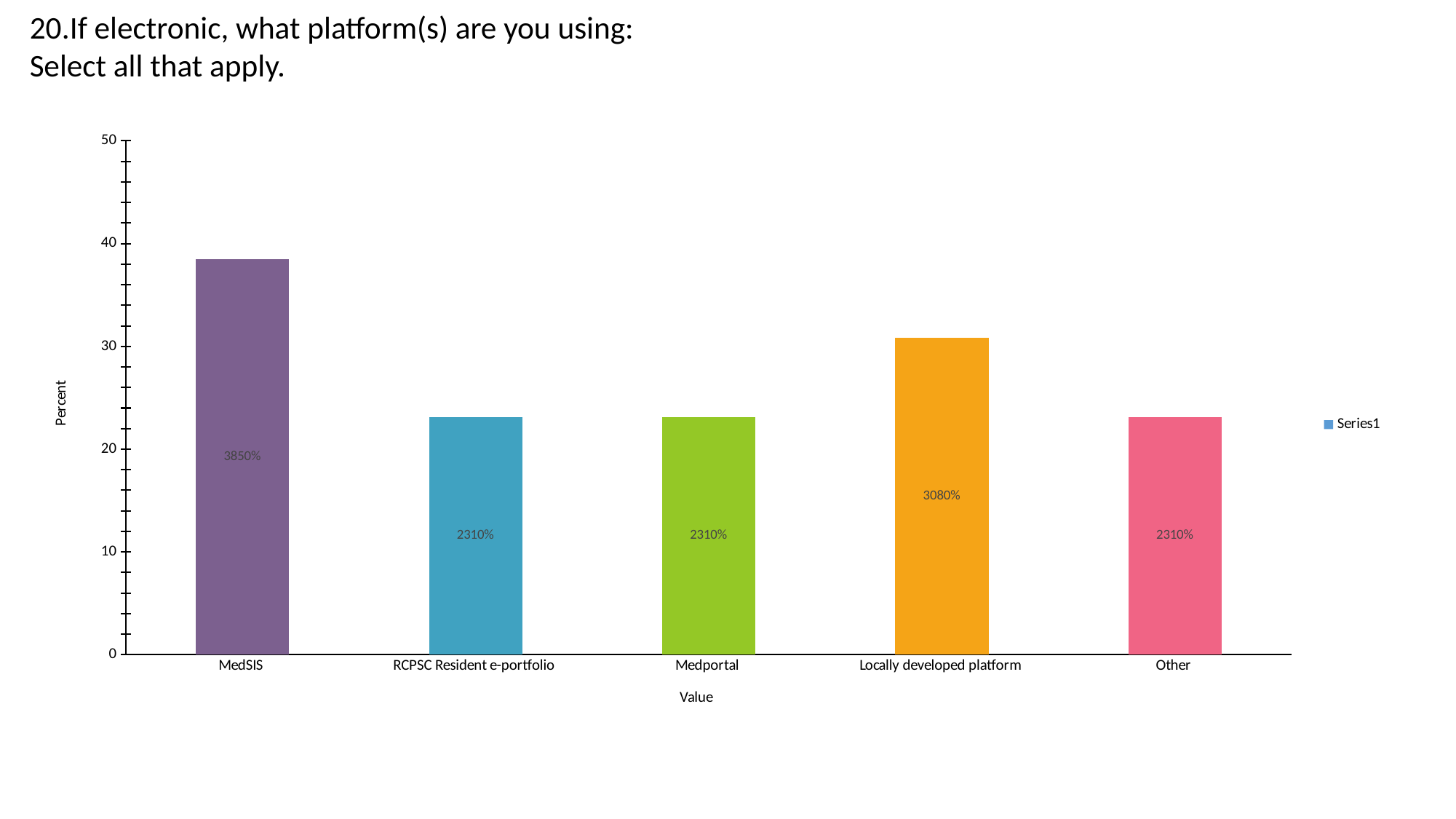
What is the data label shown on the Other bar? 2310% How many series does the legend list? 1 What kind of chart is shown on the slide? Bar chart How many platform categories are shown on the x axis? 5 Which is larger, the value for Locally developed platform or the value for Medportal? Locally developed platform What is the difference between the data labels for MedSIS and Locally developed platform? 770% Which platform has the highest bar? MedSIS Which is larger, the value for MedSIS or the value for Locally developed platform? MedSIS Is the value for RCPSC Resident e-portfolio greater or less than 30 on the Percent axis? less What is the data label shown on the MedSIS bar? 3850% What is the data label shown on the Locally developed platform bar? 3080% Is the value for MedSIS greater or less than 30 on the Percent axis? greater